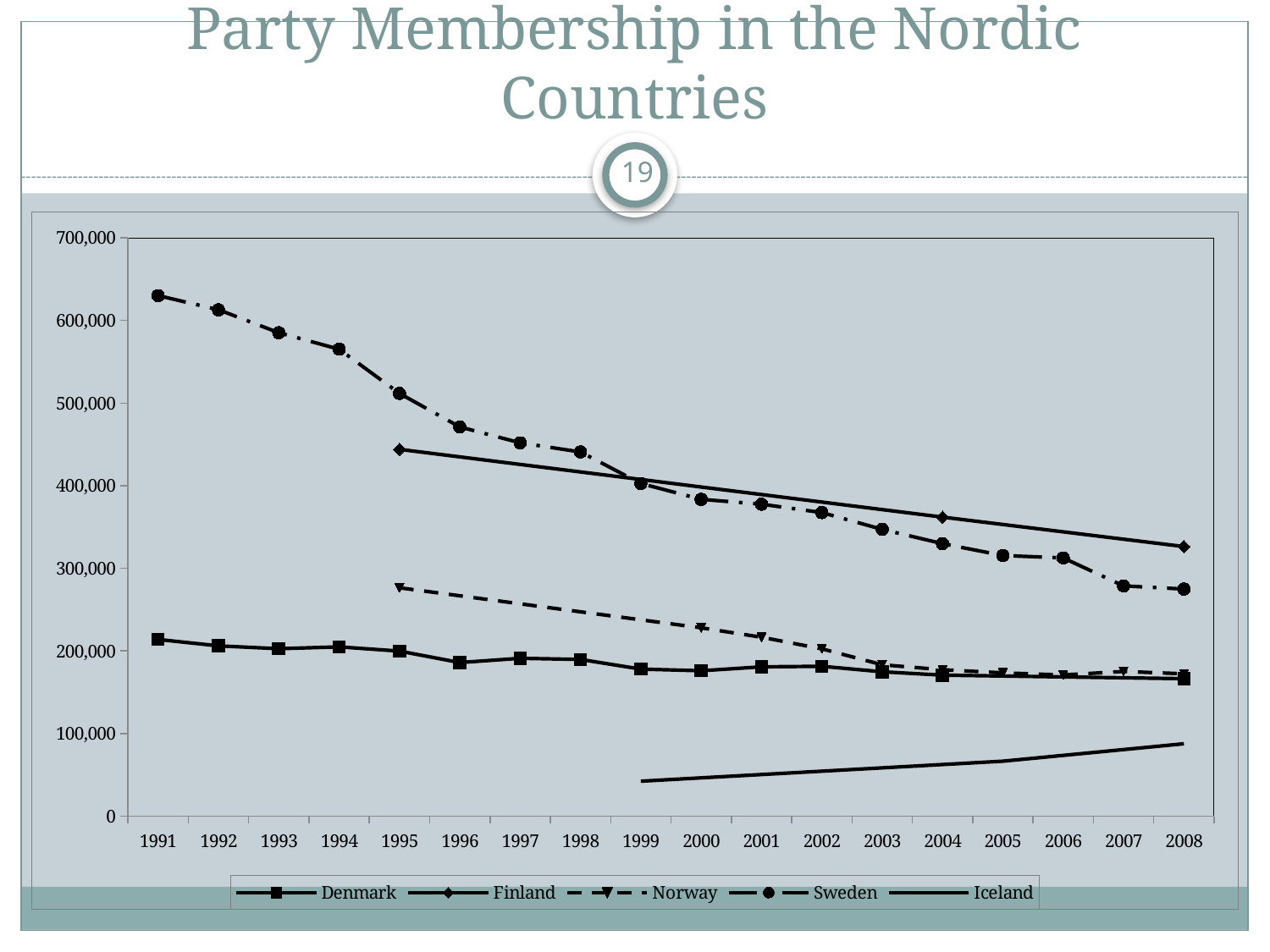
How many series does the legend list? 5 Is the value for Finland in 1995 greater or less than 400,000? greater Is the value for Iceland in 2008 greater or less than 100,000? less Which country has the lowest party membership in 2008? Iceland What kind of chart is shown on the slide? line chart Which is larger in 2008, the value for Finland or the value for Sweden? Finland Which country has the highest party membership in 1991? Sweden Does the value for Iceland rise or fall from 1999 to 2008? rise What is the title of the chart? Party Membership in the Nordic Countries Does the value for Sweden rise or fall from 1991 to 2008? fall Is the value for Sweden in 1991 greater or less than 600,000? greater How many years are shown along the x axis? 18